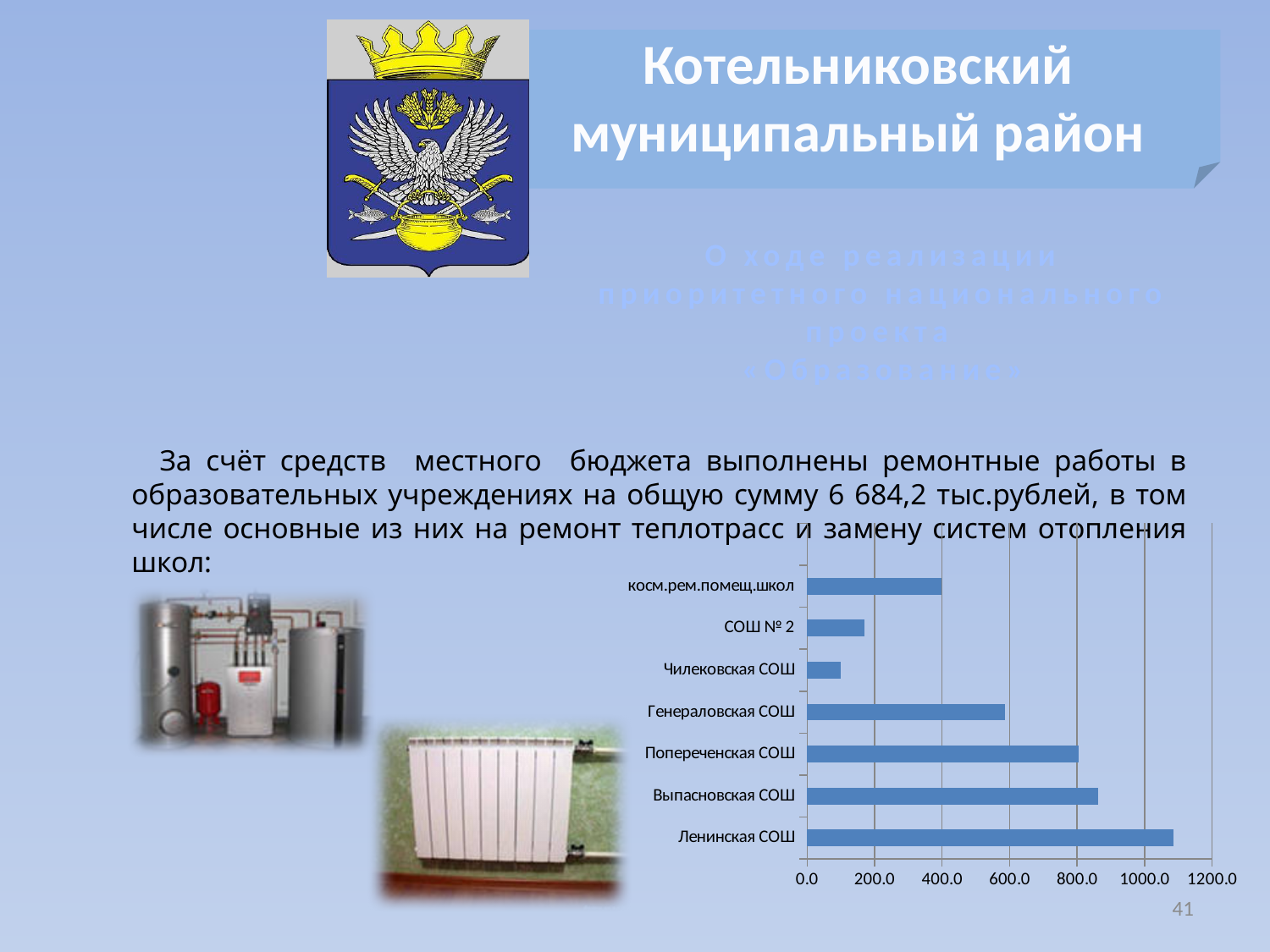
What is the highest tick value shown on the horizontal axis of the chart? 1200.0 Which category has the lowest value in the bar chart? Чилековская СОШ Which category has the highest value in the bar chart? Ленинская СОШ Which has the larger value, Выпасновская СОШ or Генераловская СОШ? Выпасновская СОШ Is the value for Выпасновская СОШ greater or less than 800.0? greater Is the value for Чилековская СОШ greater or less than 200.0? less Is the value for Генераловская СОШ greater or less than 400.0? greater Which has the larger value, СОШ № 2 or Попереченская СОШ? Попереченская СОШ What kind of chart is shown on the slide? bar chart How many categories (schools/items) are plotted in the bar chart? 7